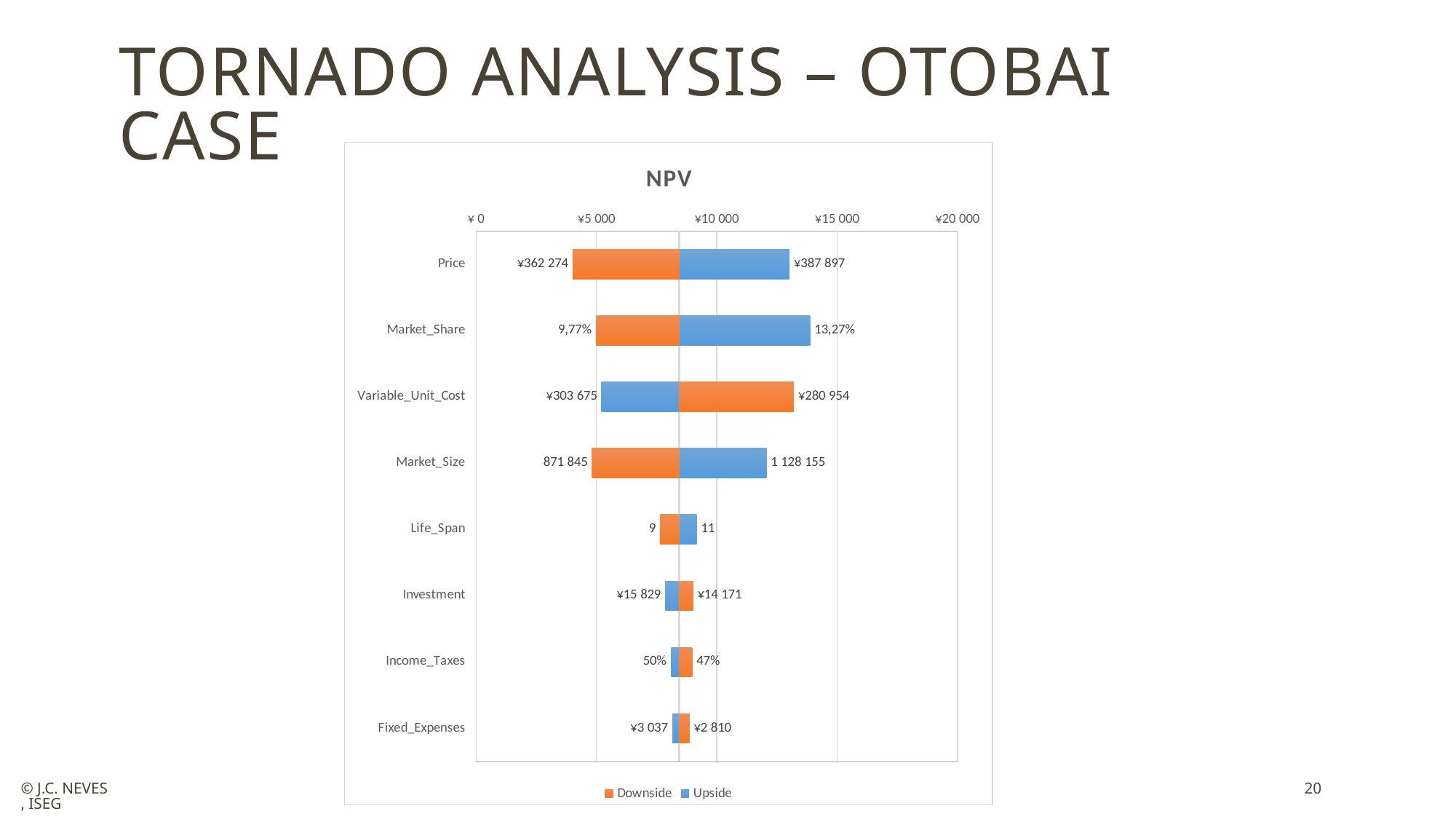
Which category has the widest total bar (largest NPV range)? Price Is the right end of the Upside bar for Price greater or less than ¥10 000? greater How many categories are listed on the vertical axis of the chart? 8 What is the title of the chart? NPV How many series does the legend list? 2 What label is printed at the left end of the Life_Span bar? 9 Which category has the narrowest total bar (smallest NPV range)? Fixed_Expenses What kind of chart is shown on the slide? bar chart Is the left end of the Downside bar for Price greater or less than ¥5 000? less Which two series are listed in the legend? Downside and Upside Is the right end of the Upside bar for Market_Share greater or less than ¥15 000? less What label is printed at the right end of the Market_Share bar? 13,27%